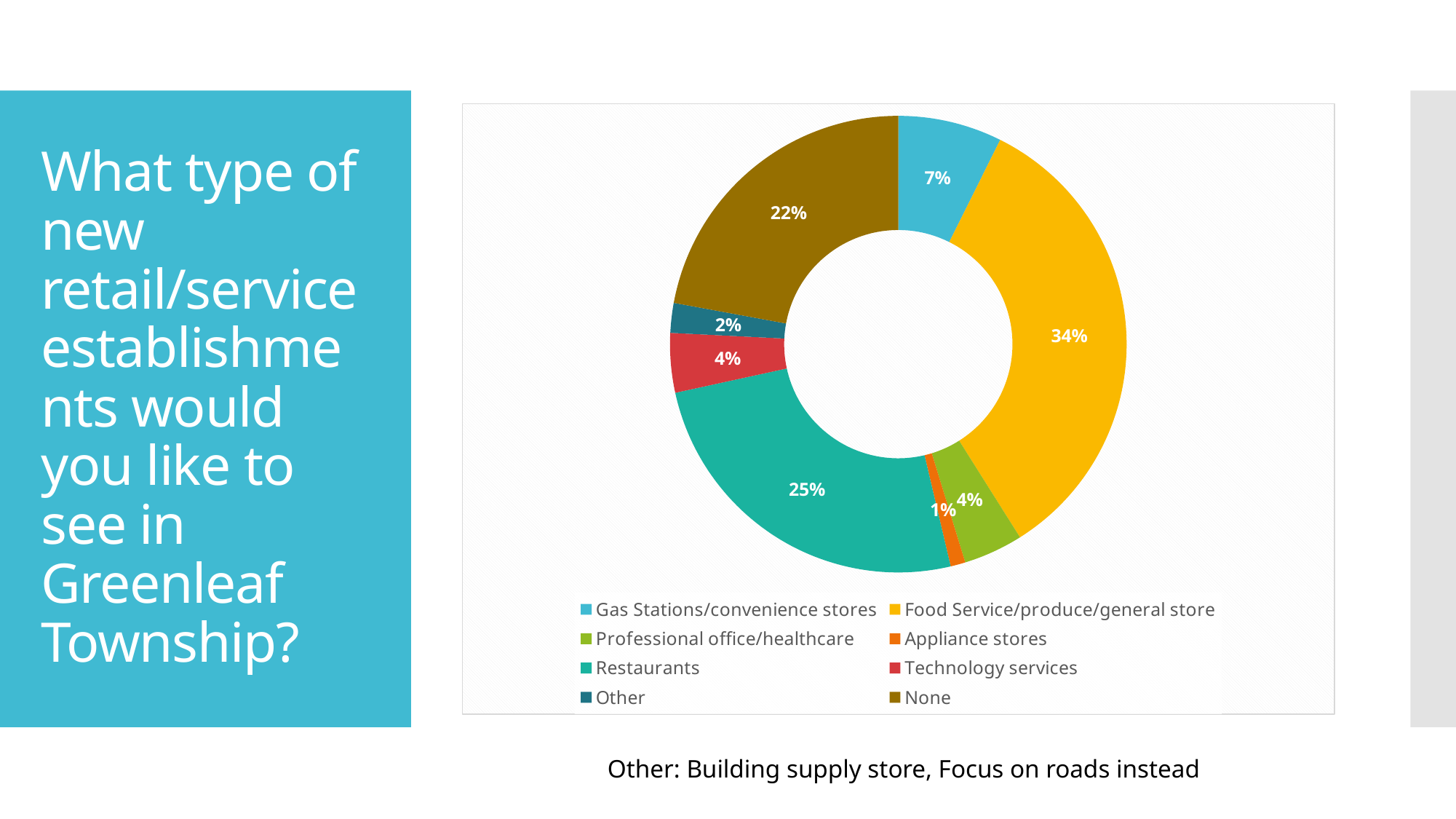
What percentage is shown for Appliance stores? 1% What percentage is shown for None? 22% Which is larger, the share for None or the share for Restaurants? Restaurants How many categories does the chart show? 8 How many percentage points larger is Food Service/produce/general store than Restaurants? 9 What kind of chart is shown on the slide? Doughnut chart What percentage is shown for Gas Stations/convenience stores? 7% What share of the chart is Restaurants? 25% Which category has the largest share of the chart? Food Service/produce/general store What colour is the Restaurants slice? Teal Which category has the smallest share of the chart? Appliance stores What percentage of respondents chose Food Service/produce/general store? 34%